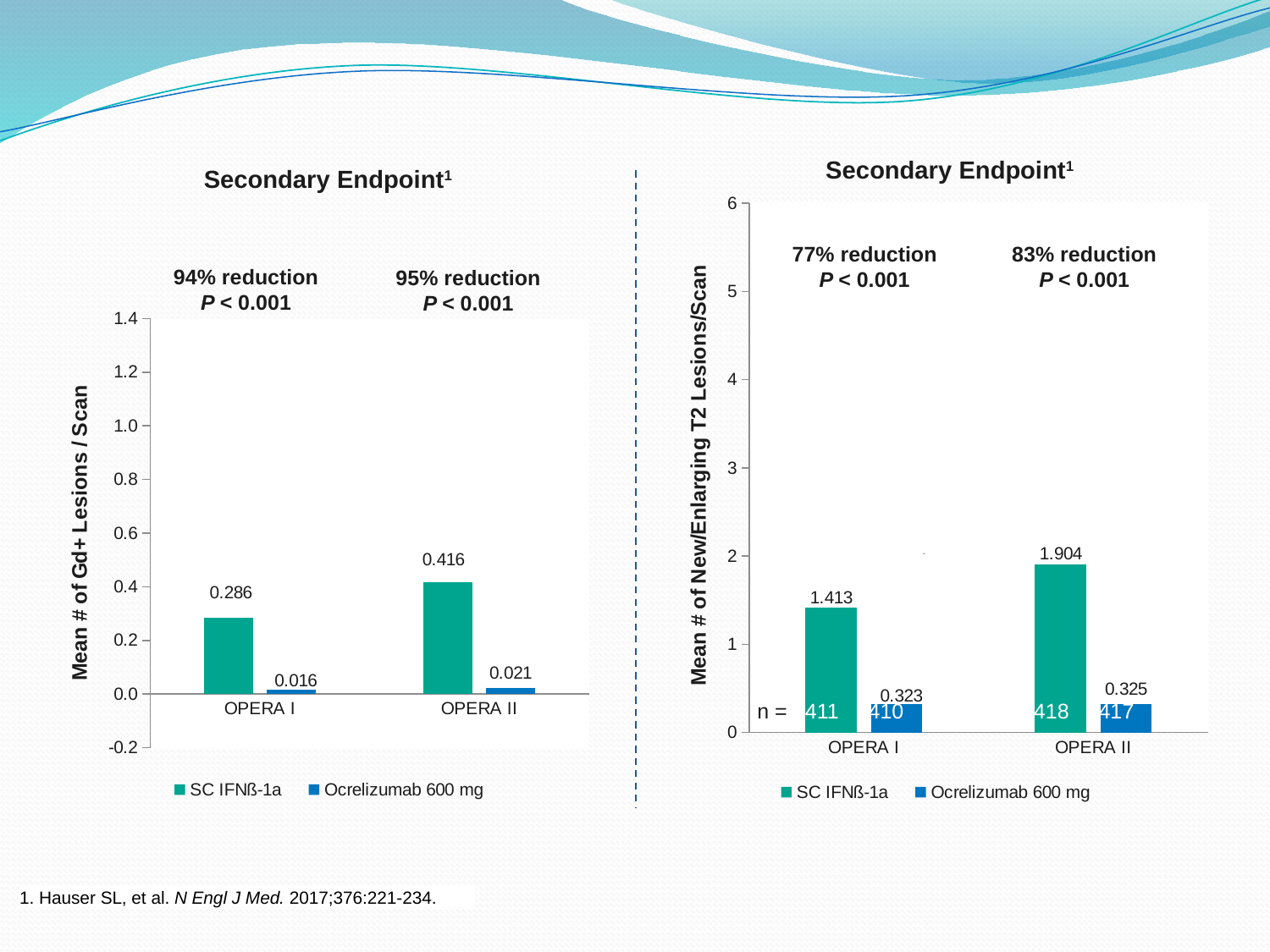
In the right chart (Mean # of New/Enlarging T2 Lesions/Scan), which bar has the lowest value? Ocrelizumab 600 mg in OPERA I In the right chart (Mean # of New/Enlarging T2 Lesions/Scan), what is the difference between the SC IFNß-1a values for OPERA II and OPERA I? 0.491 In the right chart (Mean # of New/Enlarging T2 Lesions/Scan), what percentage reduction is shown for OPERA II? 83% reduction In the right chart (Mean # of New/Enlarging T2 Lesions/Scan), which is larger: SC IFNß-1a in OPERA I or SC IFNß-1a in OPERA II? SC IFNß-1a in OPERA II In the left chart (Mean # of Gd+ Lesions / Scan), which bar has the highest value? SC IFNß-1a in OPERA II In the right chart (Mean # of New/Enlarging T2 Lesions/Scan), what is the value for Ocrelizumab 600 mg in OPERA I? 0.323 In the left chart (Mean # of Gd+ Lesions / Scan), what is the value for Ocrelizumab 600 mg in OPERA II? 0.021 In the left chart (Mean # of Gd+ Lesions / Scan), what is the difference between the SC IFNß-1a and Ocrelizumab 600 mg values in OPERA I? 0.270 In the left chart (Mean # of Gd+ Lesions / Scan), what is the value for SC IFNß-1a in OPERA I? 0.286 In the right chart (Mean # of New/Enlarging T2 Lesions/Scan), what is the value for SC IFNß-1a in OPERA II? 1.904 How many series does the legend of the left chart (Mean # of Gd+ Lesions / Scan) list? 2 What kind of chart is the right chart (Mean # of New/Enlarging T2 Lesions/Scan)? Bar chart